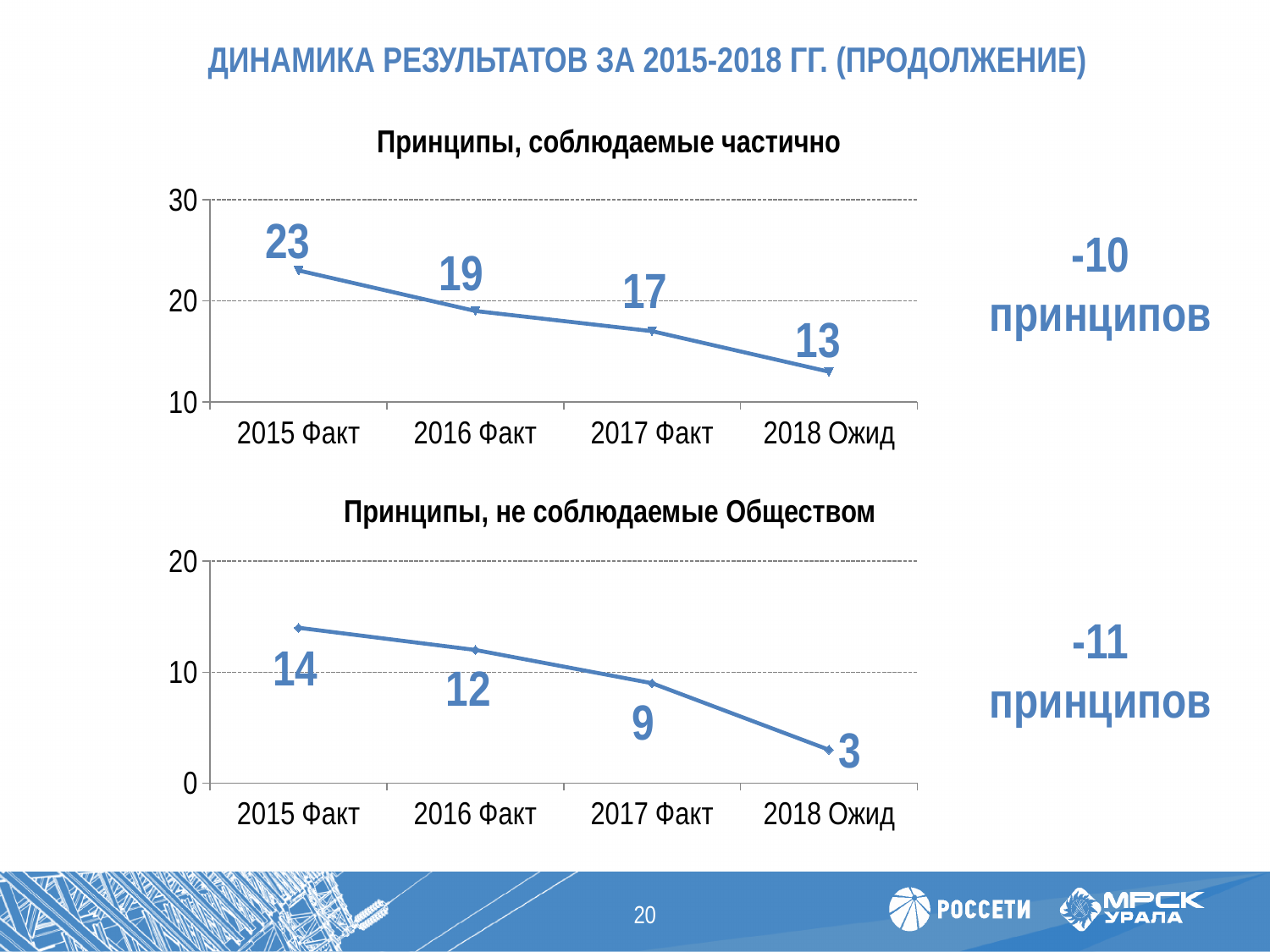
In the chart 'Принципы, соблюдаемые частично', what is the value for 2018 Ожид? 13 In the chart 'Принципы, соблюдаемые частично', do the values rise or fall from 2015 Факт to 2018 Ожид? Fall In the chart 'Принципы, не соблюдаемые Обществом', which is larger: the value for 2016 Факт or 2017 Факт? 2016 Факт How many data points are plotted in the chart 'Принципы, соблюдаемые частично'? 4 In the chart 'Принципы, не соблюдаемые Обществом', what is the value for 2017 Факт? 9 In the chart 'Принципы, не соблюдаемые Обществом', what is the difference between the values for 2015 Факт and 2018 Ожид? 11 In the chart 'Принципы, соблюдаемые частично', what is the difference between the values for 2015 Факт and 2018 Ожид? 10 In the chart 'Принципы, не соблюдаемые Обществом', which category has the lowest value? 2018 Ожид In the chart 'Принципы, не соблюдаемые Обществом', what is the value for 2016 Факт? 12 In the chart 'Принципы, соблюдаемые частично', what is the value for 2015 Факт? 23 What kind of chart is 'Принципы, не соблюдаемые Обществом'? Line chart In the chart 'Принципы, соблюдаемые частично', which category has the highest value? 2015 Факт